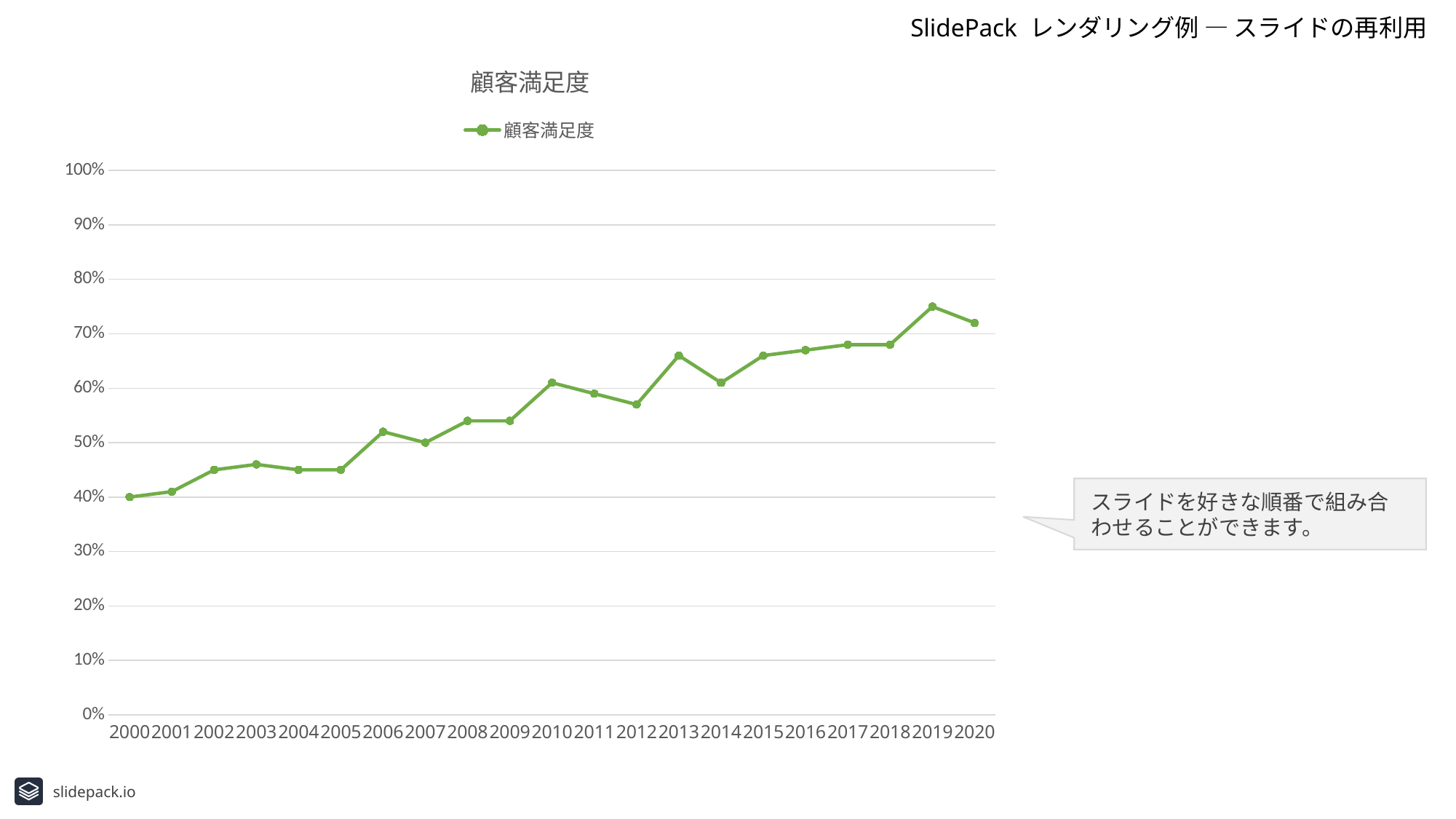
How many series does the legend list? 1 What is the value for 2000? 40% What kind of chart is shown on the slide? line chart Which year has the highest value? 2019 Is the value for 2005 greater or less than 50%? less Do the values generally rise or fall from 2000 to 2020? rise What is the value for 2007? 50% What is the title of the chart? 顧客満足度 How many years are plotted on the x axis? 21 Is the value for 2019 greater or less than 70%? greater Is the value for 2013 greater or less than 60%? greater Which is larger, the value for 2013 or the value for 2014? 2013